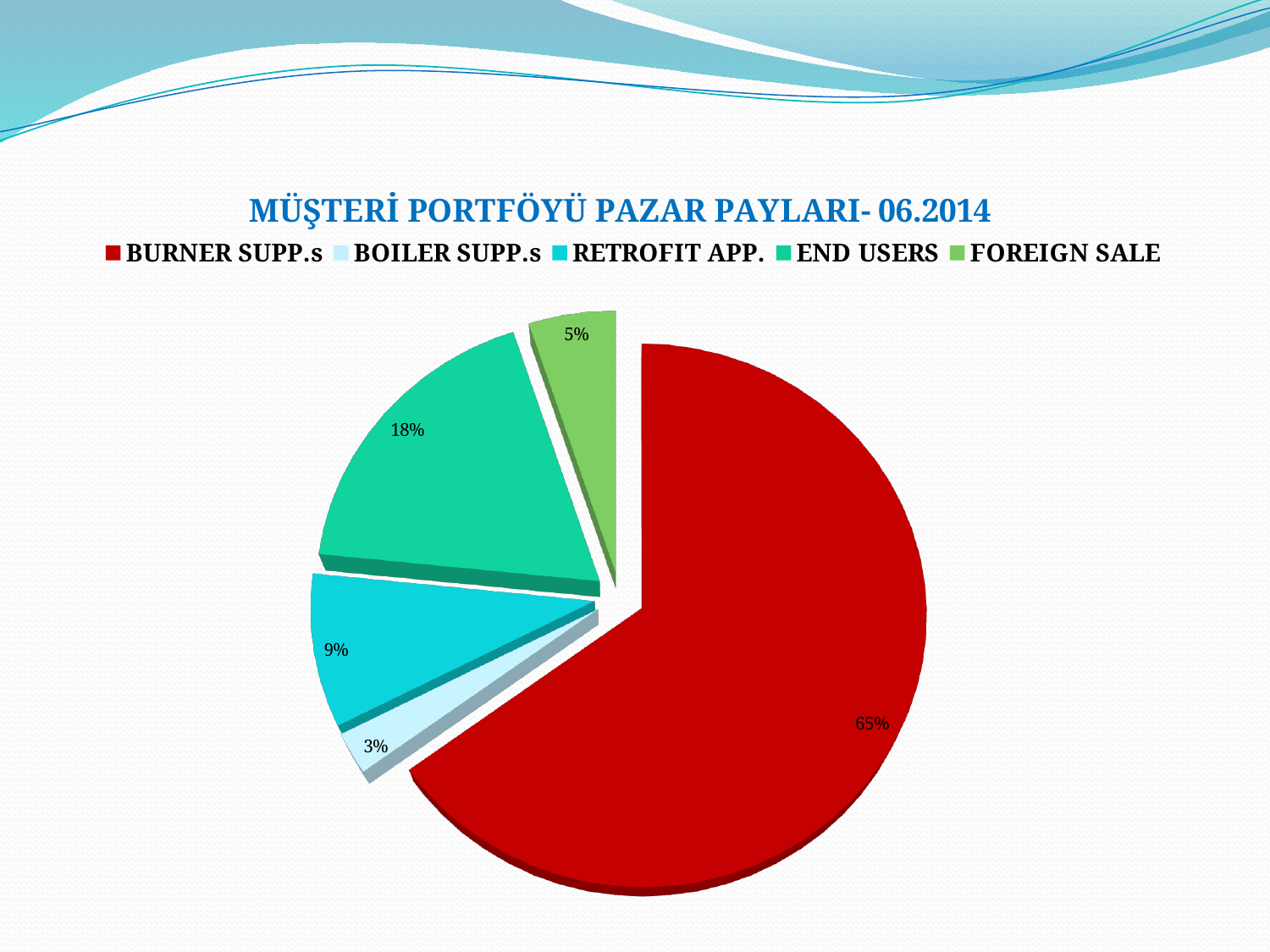
What is the value shown for FOREIGN SALE? 5% How many categories are shown in the pie chart? 5 What kind of chart is shown on the slide? Pie chart What is the difference between the shares of END USERS and RETROFIT APP.? 9% What is the title of the chart? MÜŞTERİ PORTFÖYÜ PAZAR PAYLARI- 06.2014 Which category has the smallest slice of the pie? BOILER SUPP.s Which is larger, the share for FOREIGN SALE or the share for BOILER SUPP.s? FOREIGN SALE What is the value shown for RETROFIT APP.? 9% What is the value shown for BOILER SUPP.s? 3% What share of the pie does BURNER SUPP.s hold? 65% What is the value shown for END USERS? 18% Which category has the largest slice of the pie? BURNER SUPP.s